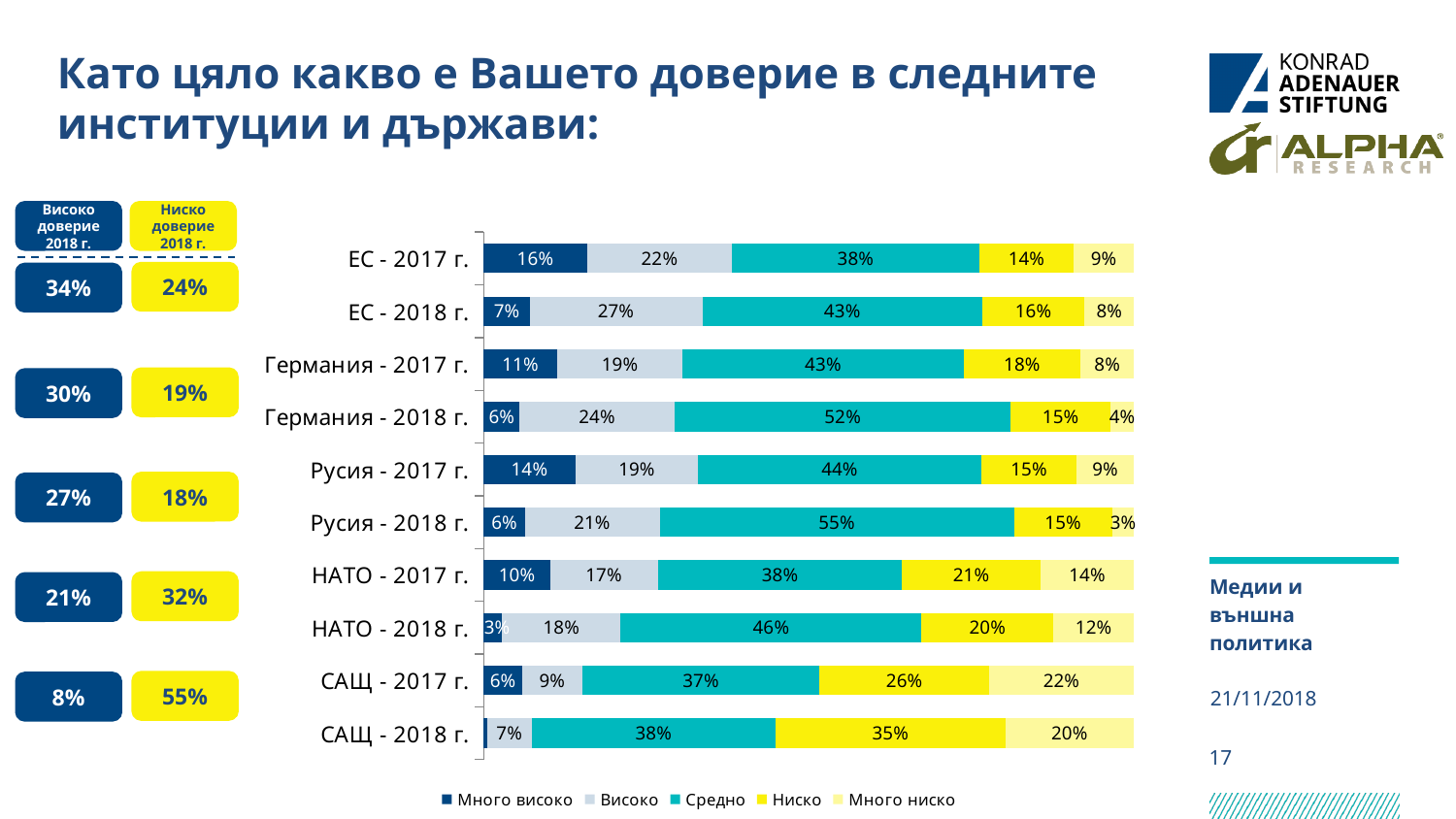
What is the value of the "Много високо" segment for "ЕС - 2017 г."? 16% What is the value of the "Ниско" segment for "НАТО - 2018 г."? 20% What is the value of the "Средно" segment for "Русия - 2018 г."? 55% Which category has the lowest "Много ниско" value? Русия - 2018 г. Which legend entry is shown in dark blue? Много високо What is the value of the "Много ниско" segment for "САЩ - 2017 г."? 22% What is the difference between the "Средно" values for "Германия - 2018 г." and "Германия - 2017 г."? 9% What kind of chart is shown on the slide? stacked bar chart How many category bars are plotted in the chart? 10 Which category has the highest "Средно" value? Русия - 2018 г. How many series does the chart legend list? 5 Which is larger: the "Ниско" value for "САЩ - 2017 г." or for "НАТО - 2017 г."? САЩ - 2017 г.